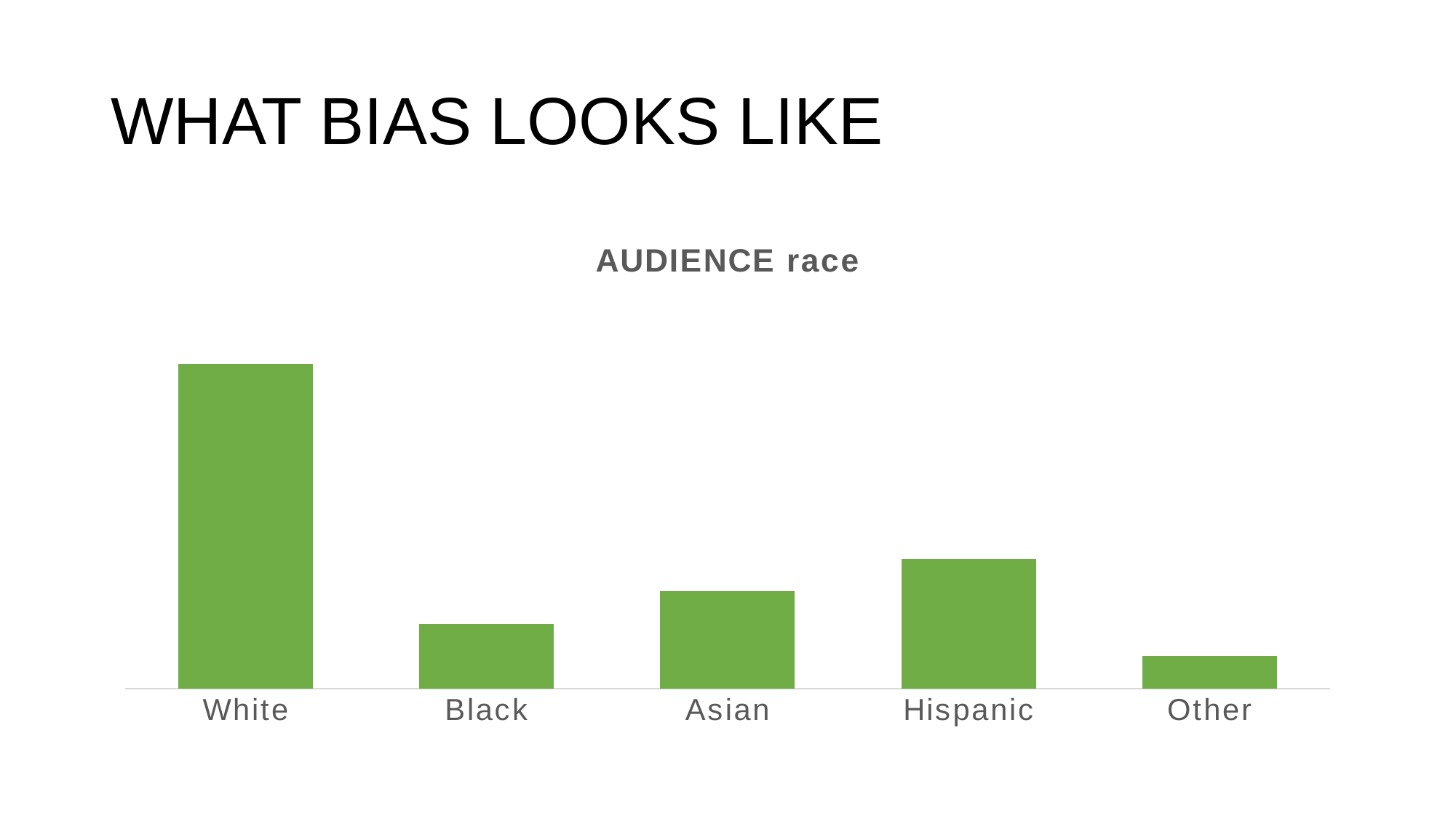
What colour are the bars in the chart? green Which bar is taller, Black or Other? Black Which category has the lowest bar in the chart? Other How many categories are shown on the x axis of the chart? 5 Which category has the second-highest bar in the chart? Hispanic Which bar is taller, Hispanic or Asian? Hispanic What type of chart is shown on the slide? bar chart Which bar is taller, Asian or Black? Asian Which category has the highest bar in the chart? White What is the title of the chart? AUDIENCE race